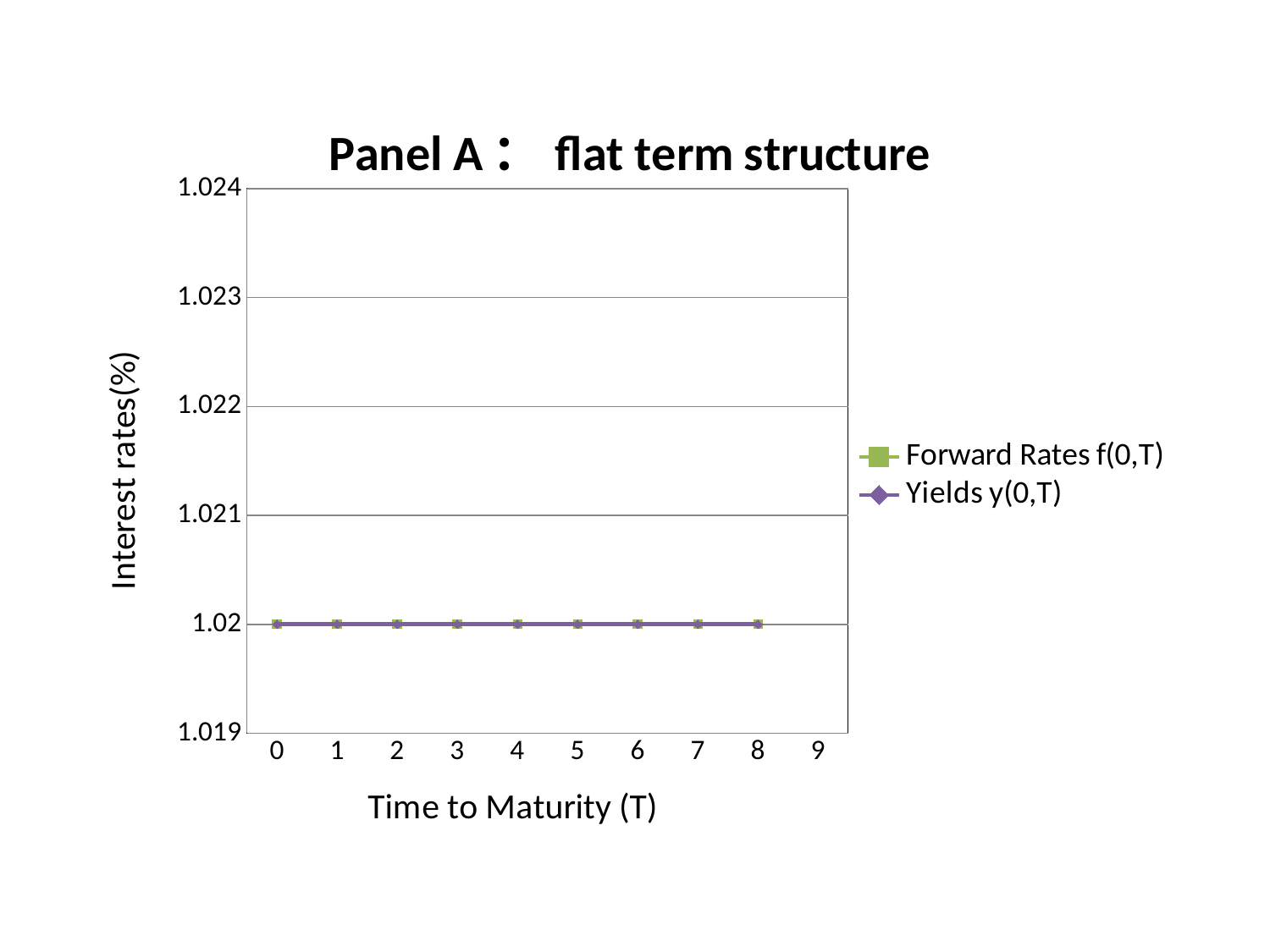
What is the value of Yields y(0,T) at time to maturity 8? 1.02 How many data points are plotted for the Forward Rates f(0,T) series? 9 What are the two series named in the legend? Forward Rates f(0,T) and Yields y(0,T) Do the Yields y(0,T) values rise, fall, or stay flat along the x axis? stay flat What is the title of the chart? Panel A: flat term structure What is the difference between Forward Rates f(0,T) and Yields y(0,T) at time to maturity 5? 0 How many series does the legend list? 2 Is the value of Yields y(0,T) at time to maturity 2 greater or less than 1.021? less What is the value of Forward Rates f(0,T) at time to maturity 0? 1.02 What kind of chart is shown on the slide? line chart What is the value of Yields y(0,T) at time to maturity 4? 1.02 Do the Forward Rates f(0,T) values rise, fall, or stay flat as time to maturity increases? stay flat